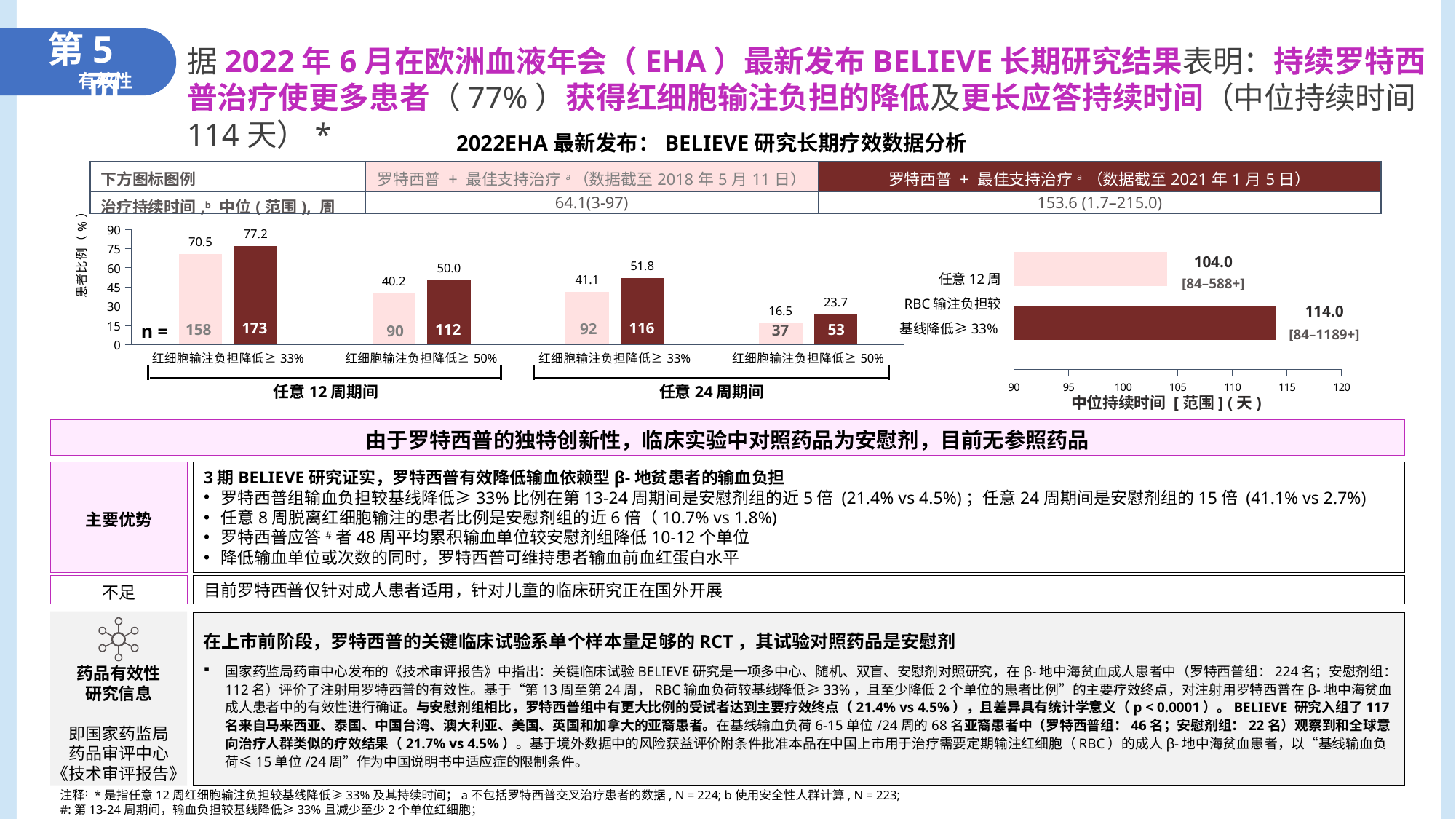
In the left bar chart (患者比例), which is larger: the 2018 data cutoff value for 任意 12 周期间 红细胞输注负担降低≥33% or the 2018 data cutoff value for 任意 24 周期间 红细胞输注负担降低≥33%? 任意 12 周期间 红细胞输注负担降低≥33% (70.5) In the left bar chart (患者比例), what is the n value shown for the 2021 data cutoff series in the 任意 24 周期间 红细胞输注负担降低≥33% category? 116 In the right chart (中位持续时间), what is the median duration for 罗特西普 + 最佳支持治疗 (数据截至 2021 年 1 月 5 日)? 114.0 What kind of chart is the left chart (患者比例)? Bar chart In the left bar chart (患者比例), what is the value for 罗特西普 + 最佳支持治疗 (数据截至 2018 年 5 月 11 日) in the 任意 24 周期间 红细胞输注负担降低≥50% category? 16.5 In the left bar chart (患者比例), which bar has the highest value? 任意 12 周期间 红细胞输注负担降低≥33%, 2021 data cutoff (77.2) How many series does the legend list for the charts on this slide? 2 In the left bar chart (患者比例), what is the difference between the 2021 and 2018 data cutoff values in the 任意 12 周期间 红细胞输注负担降低≥50% category? 9.8 In the right chart (中位持续时间), is the value for the 2018 data cutoff bar greater or less than 100? greater In the left bar chart (患者比例), what is the lowest plotted value? 16.5 In the left bar chart (患者比例), what is the value for 罗特西普 + 最佳支持治疗 (数据截至 2021 年 1 月 5 日) in the 任意 12 周期间 红细胞输注负担降低≥33% category? 77.2 In the right chart (中位持续时间), what is the difference between the 2021 data cutoff median duration and the 2018 data cutoff median duration? 10.0